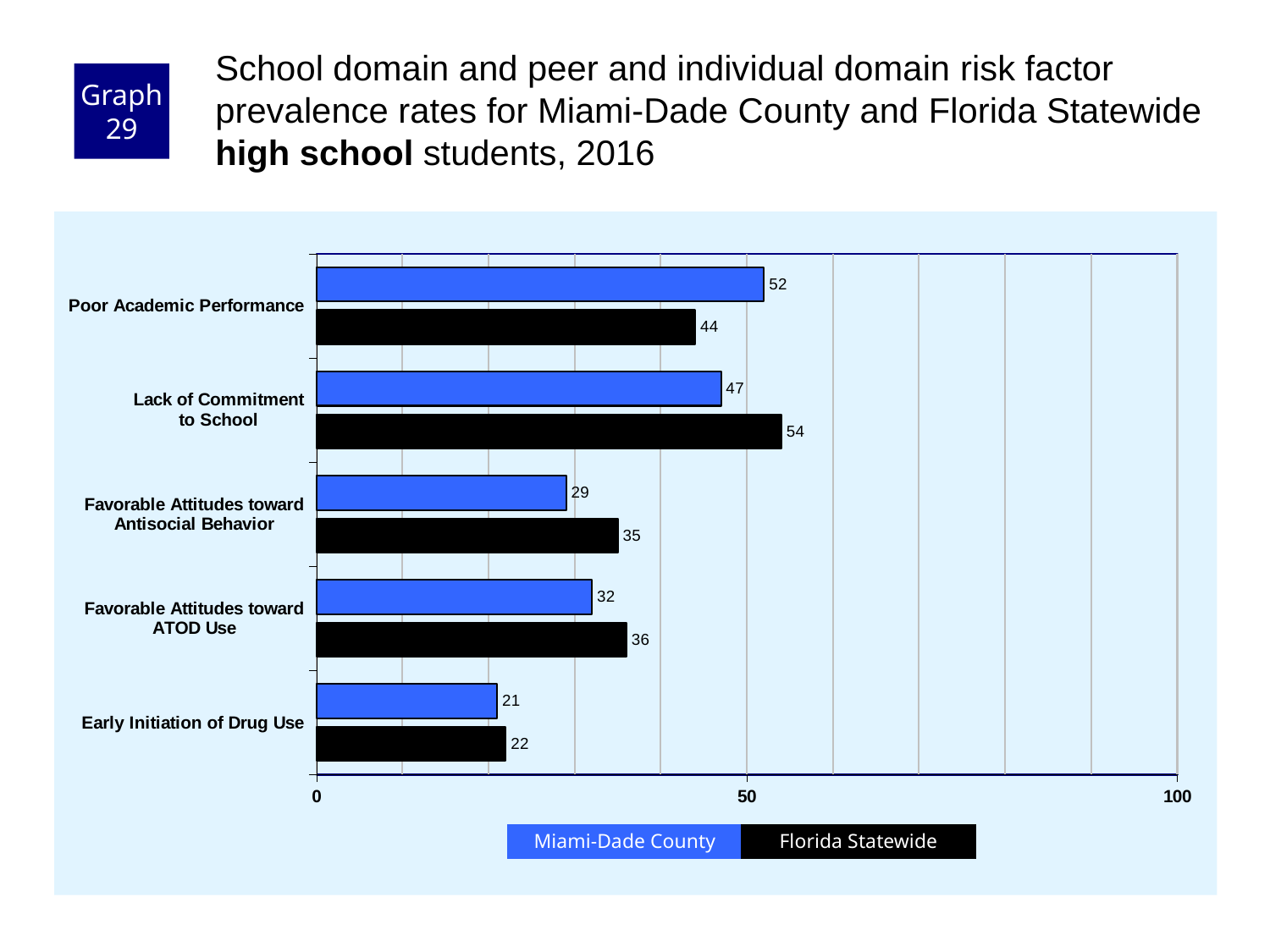
Is the Florida Statewide value for Favorable Attitudes toward ATOD Use greater or less than 50? less What is the difference between the Miami-Dade County and Florida Statewide values for Poor Academic Performance? 8 What is the Miami-Dade County value for Early Initiation of Drug Use? 21 Which category has the highest Florida Statewide value? Lack of Commitment to School What is the Miami-Dade County value for Poor Academic Performance? 52 How many series does the legend list? 2 What kind of chart is shown on the slide? bar chart For Favorable Attitudes toward Antisocial Behavior, which is larger: Miami-Dade County or Florida Statewide? Florida Statewide How many risk factor categories are shown on the chart? 5 Which category has the lowest Miami-Dade County value? Early Initiation of Drug Use Which colour represents Florida Statewide in the chart? black What is the Florida Statewide value for Lack of Commitment to School? 54